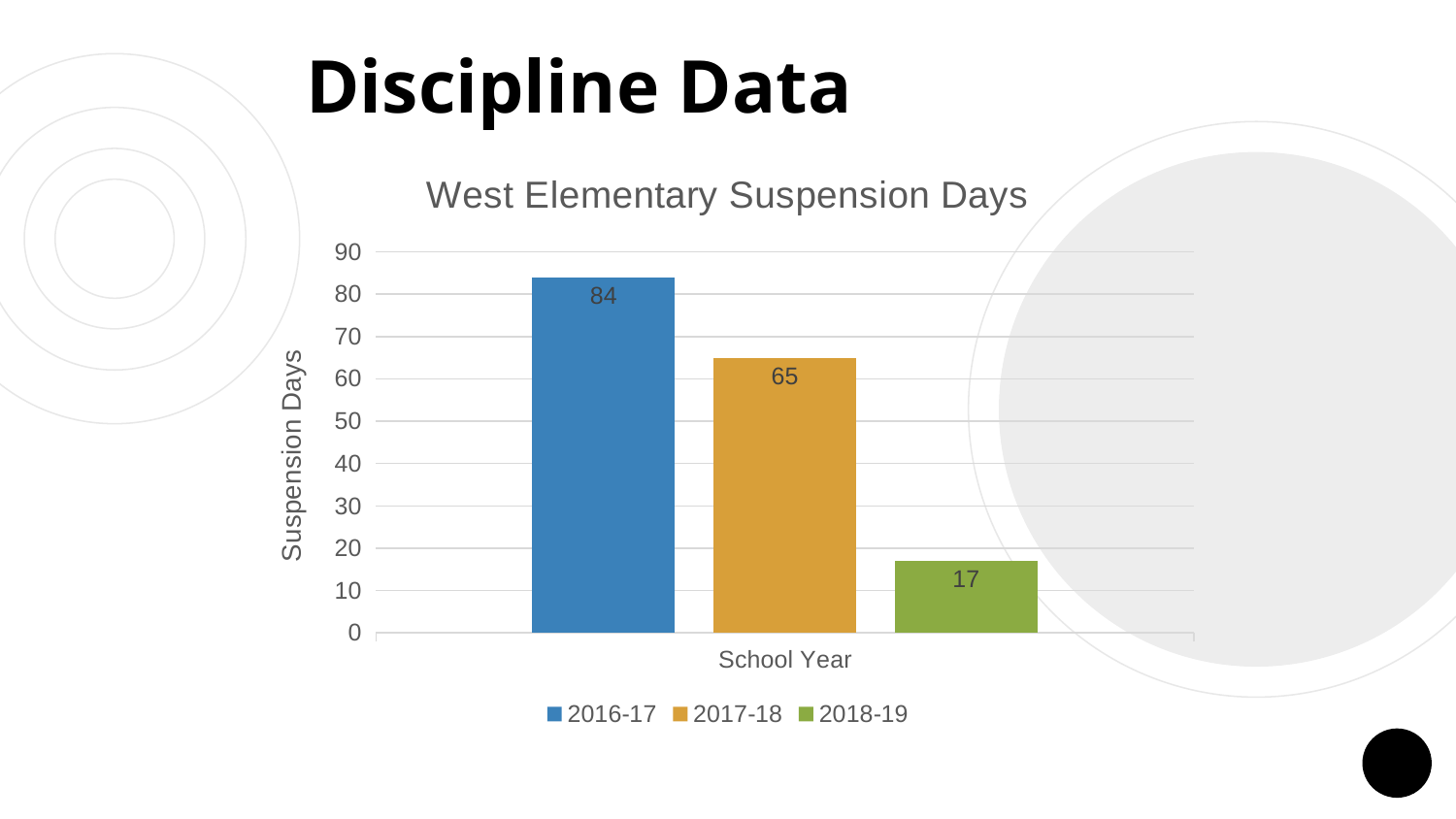
Is the value for 2016-17 greater or less than 80? greater How many series does the legend list? 3 Which has more suspension days, 2017-18 or 2018-19? 2017-18 What is the difference in suspension days between 2016-17 and 2017-18? 19 What is the value for 2017-18 in the West Elementary Suspension Days chart? 65 Which school year has the highest number of suspension days? 2016-17 What is the value for 2018-19 in the West Elementary Suspension Days chart? 17 Which school year has the lowest number of suspension days? 2018-19 What is the value for 2016-17 in the West Elementary Suspension Days chart? 84 What is the difference in suspension days between 2017-18 and 2018-19? 48 Do suspension days rise or fall from 2016-17 to 2018-19? Fall What kind of chart is shown on the slide? Bar chart